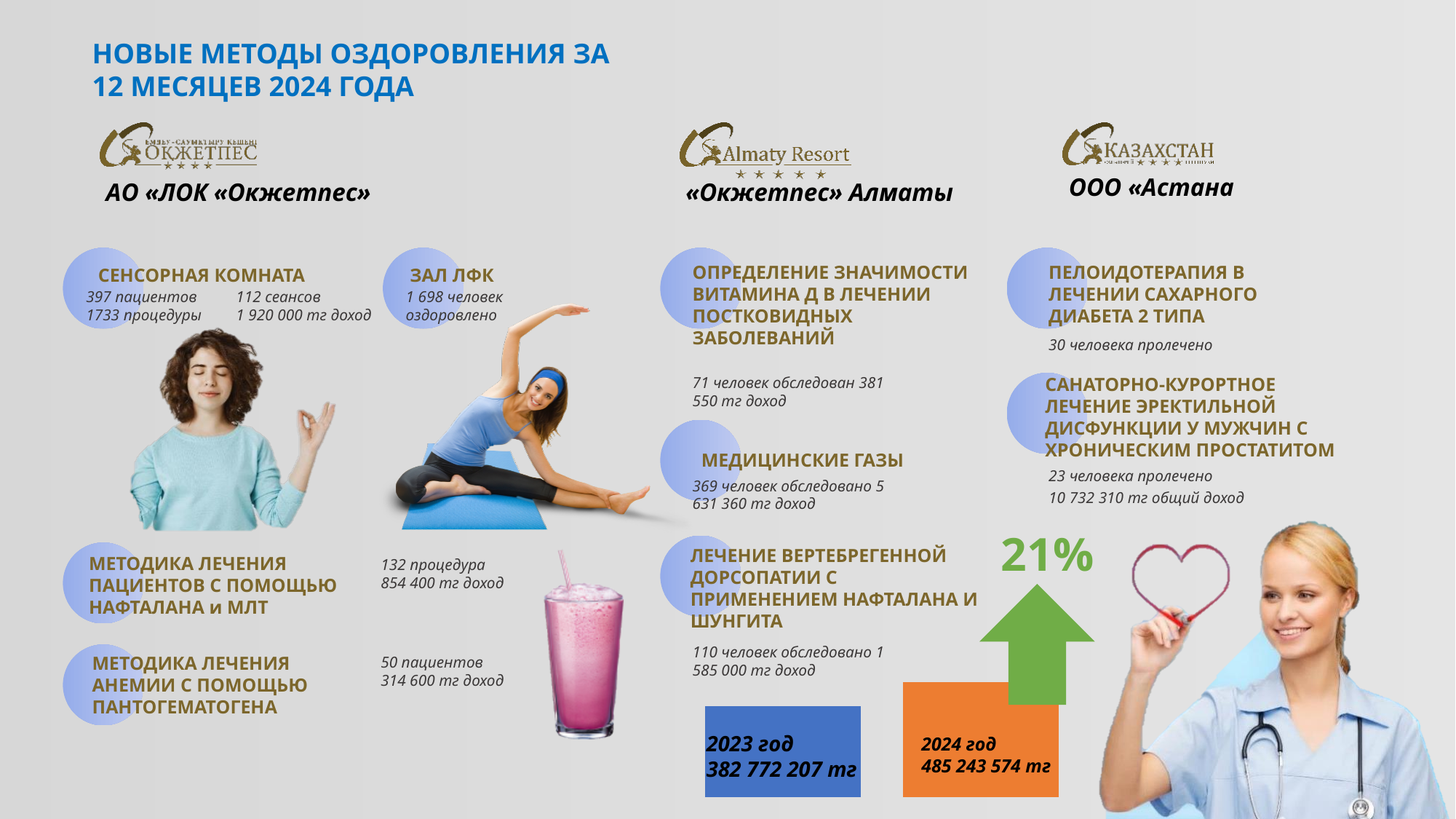
In the bar chart at the bottom of the slide, what is the difference between the 2024 год and 2023 год values? 102 471 367 тг What kind of chart is shown at the bottom of the slide comparing 2023 год and 2024 год? bar chart In the bar chart at the bottom of the slide, what is the value shown for 2023 год? 382 772 207 тг In the bar chart at the bottom of the slide, what colour is the bar for 2024 год? orange What percentage growth is shown above the bar chart at the bottom of the slide? 21% In the bar chart at the bottom of the slide, which year has the higher value? 2024 год How many bars (years) are shown in the bar chart at the bottom of the slide? 2 In the bar chart at the bottom of the slide, what is the value shown for 2024 год? 485 243 574 тг In the bar chart at the bottom of the slide, is the value for 2024 год larger or smaller than the value for 2023 год? larger In the bar chart at the bottom of the slide, which year has the lower value? 2023 год In the bar chart at the bottom of the slide, do the values rise or fall from 2023 год to 2024 год? rise